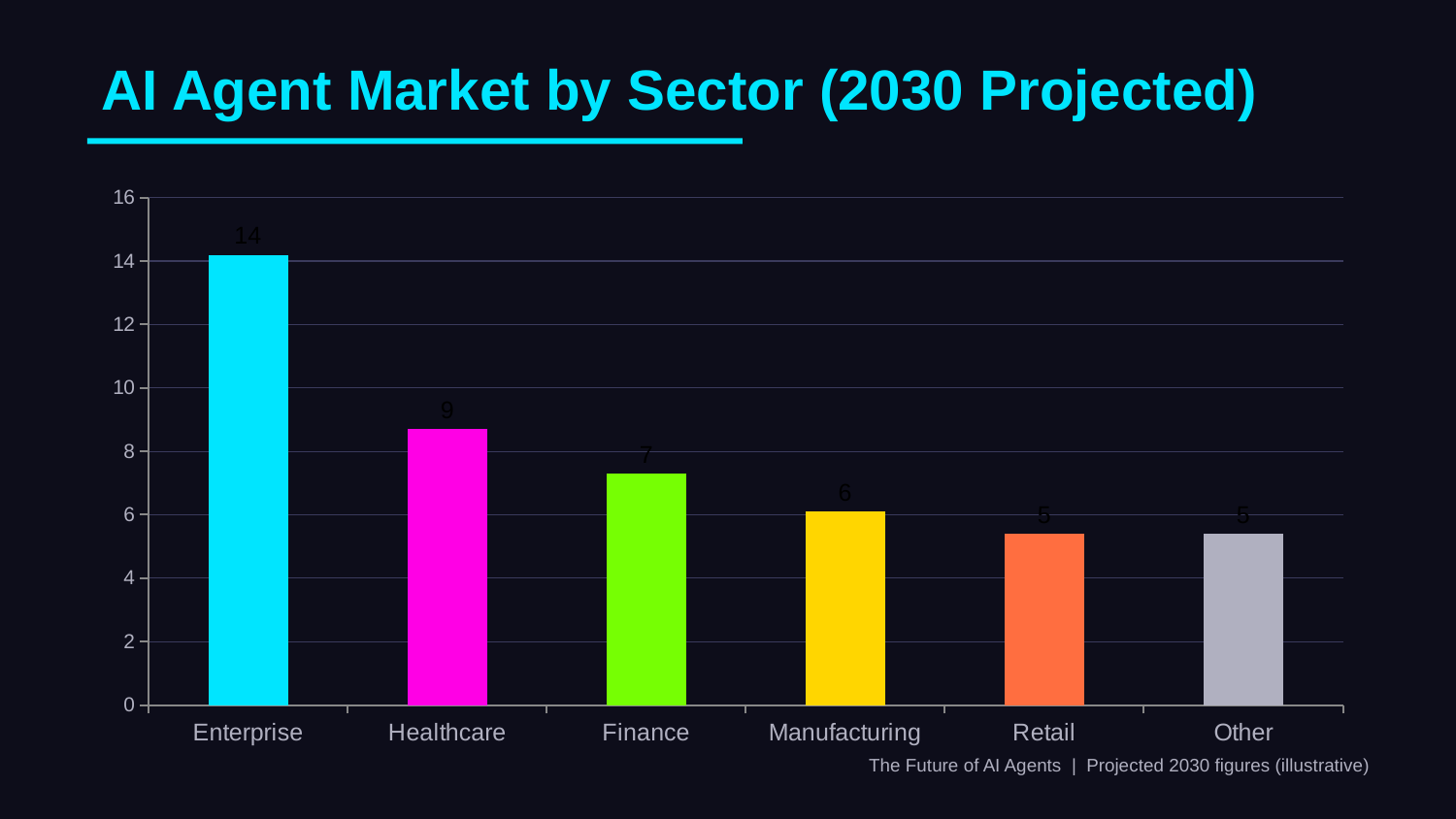
What is the value for Finance? 7 What is the value for Healthcare? 9 What is the value for Manufacturing? 6 What is the difference between the values for Enterprise and Healthcare? 5 What is the title of the chart? AI Agent Market by Sector (2030 Projected) Which is larger, the value for Finance or the value for Manufacturing? Finance Which sector has the highest value? Enterprise Do the values rise or fall from Enterprise to Retail along the x axis? fall What is the value for Enterprise? 14 How many sectors are shown on the x axis? 6 Is the value for Enterprise greater or less than 12? greater What kind of chart is shown on the slide? bar chart